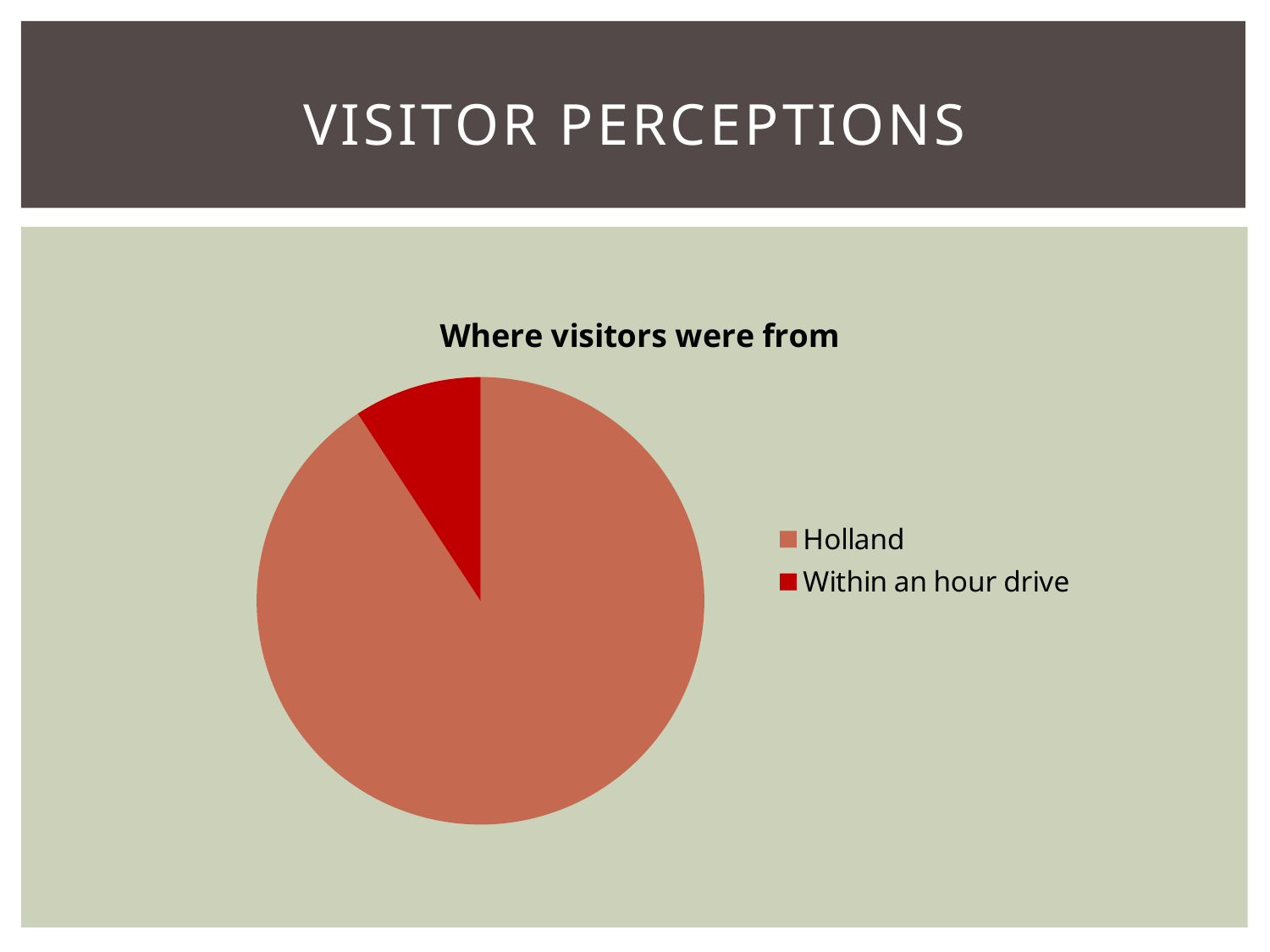
Which legend entry is shown in dark red? Within an hour drive Which category has the largest slice of the pie? Holland How many categories does the legend list? 2 Which category has the smallest slice of the pie? Within an hour drive What kind of chart is shown on the slide? pie chart Does the Holland slice make up more or less than half of the pie? more What is the title of the chart? Where visitors were from Which slice is larger, Holland or Within an hour drive? Holland